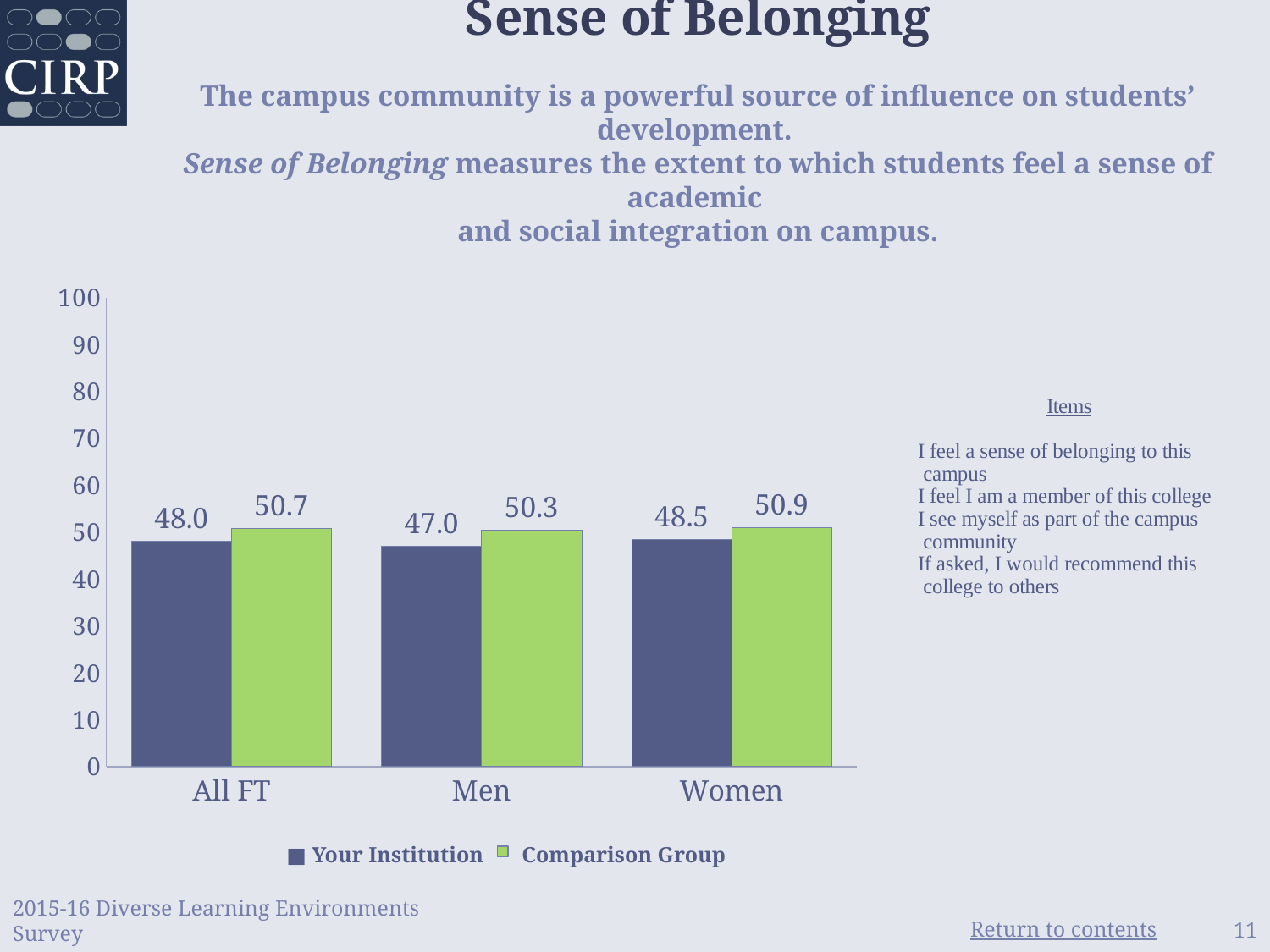
Is the Your Institution value for Men greater or less than 50? less What kind of chart is shown on the slide? bar chart Which category has the lowest Your Institution value? Men What is the difference between the Comparison Group and Your Institution values for All FT? 2.7 How many categories are shown on the x axis? 3 What is the Your Institution value for All FT? 48.0 How many series does the legend list? 2 Which category has the highest Comparison Group value? Women What is the difference between the Comparison Group and Your Institution values for Men? 3.3 For Women, which is larger: Your Institution or Comparison Group? Comparison Group What is the Comparison Group value for Women? 50.9 What is the Your Institution value for Men? 47.0